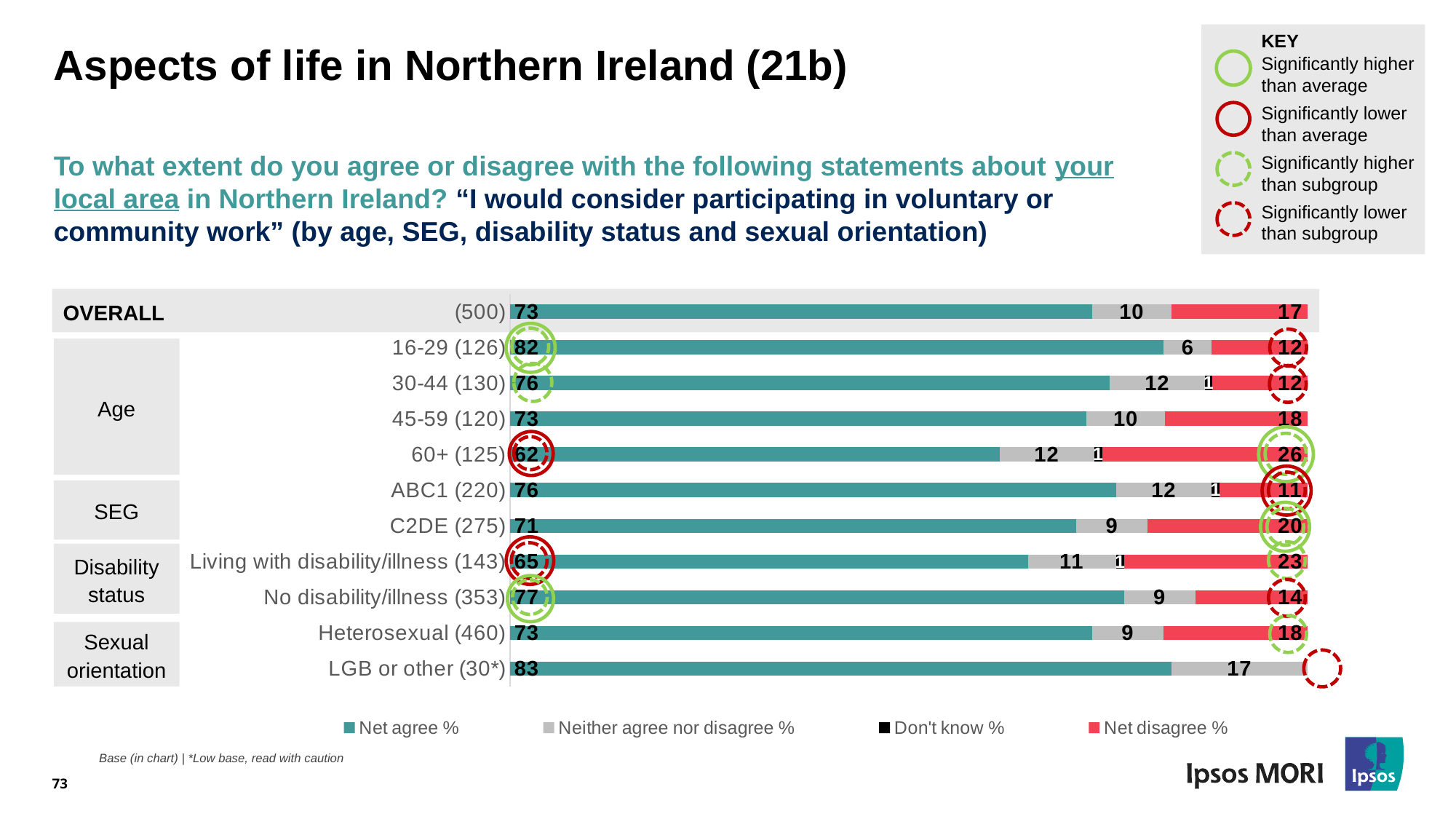
Which category has the lowest Net agree %? 60+ What kind of chart is shown on the slide? Stacked bar chart What is the base size shown for the OVERALL category? 500 What is the Net agree % for the OVERALL category? 73 What is the Neither agree nor disagree % for the 16-29 age group? 6 What is the difference in Net agree % between the 16-29 and 60+ age groups? 20 How many categories (bars) are shown in the chart? 11 What is the Net agree % for the Living with disability/illness group? 65 What is the Net disagree % for the 60+ age group? 26 How many series does the legend list? 4 Which category has the highest Net agree %? LGB or other Which has a higher Net disagree %, ABC1 or C2DE? C2DE